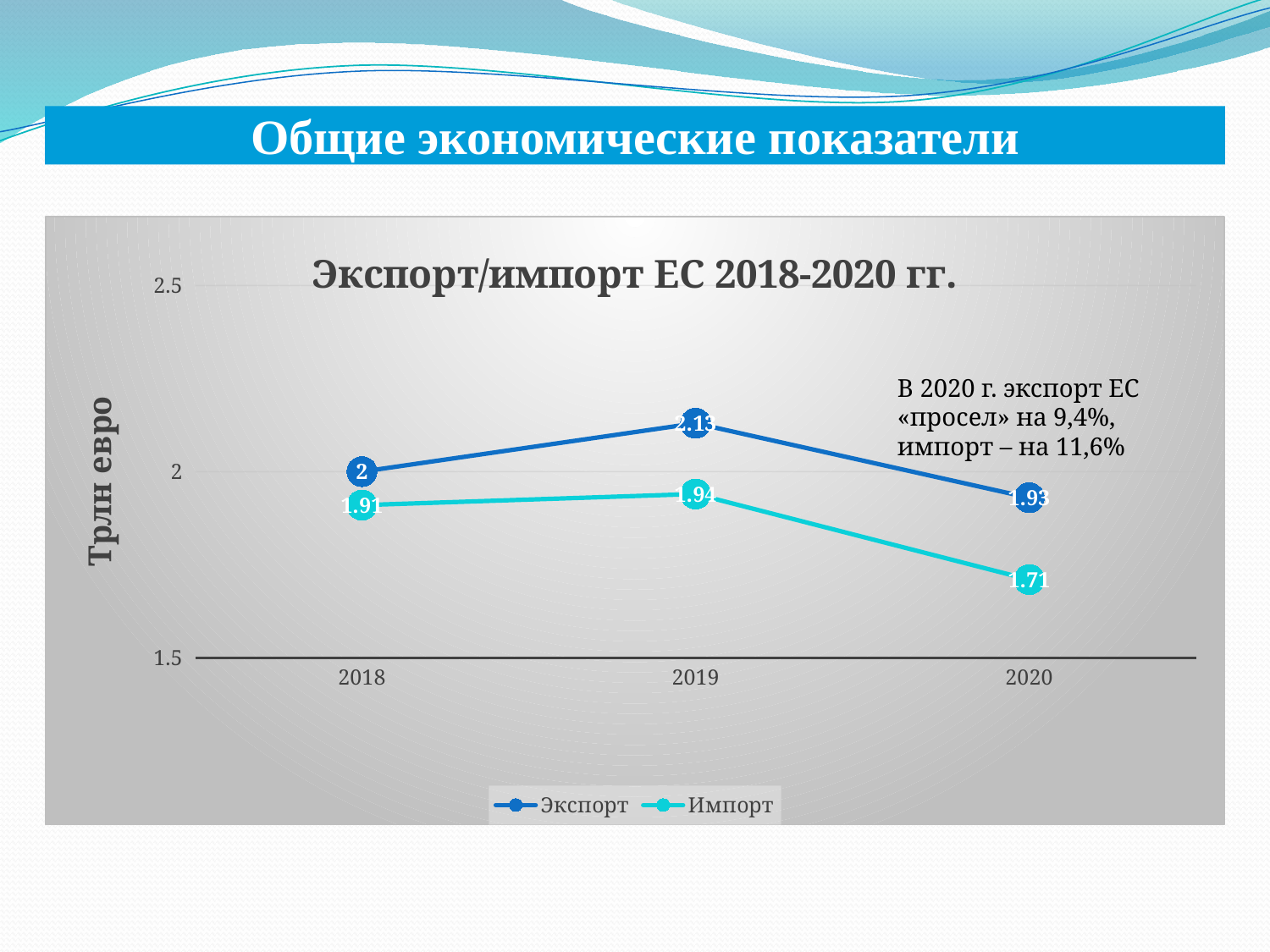
What is the value of Экспорт in 2018? 2 In which year is Импорт highest? 2019 How many series does the legend list? 2 What type of chart is shown on the slide? Line chart What is the value of Экспорт in 2019? 2.13 In which year is Экспорт lowest? 2020 Does Импорт rise or fall from 2019 to 2020? Fall What is the difference between Экспорт and Импорт in 2020? 0.22 Which is larger in 2018, Экспорт or Импорт? Экспорт What is the title of the chart? Экспорт/импорт ЕС 2018-2020 гг. How many years are plotted on the x axis? 3 What is the value of Импорт in 2020? 1.71